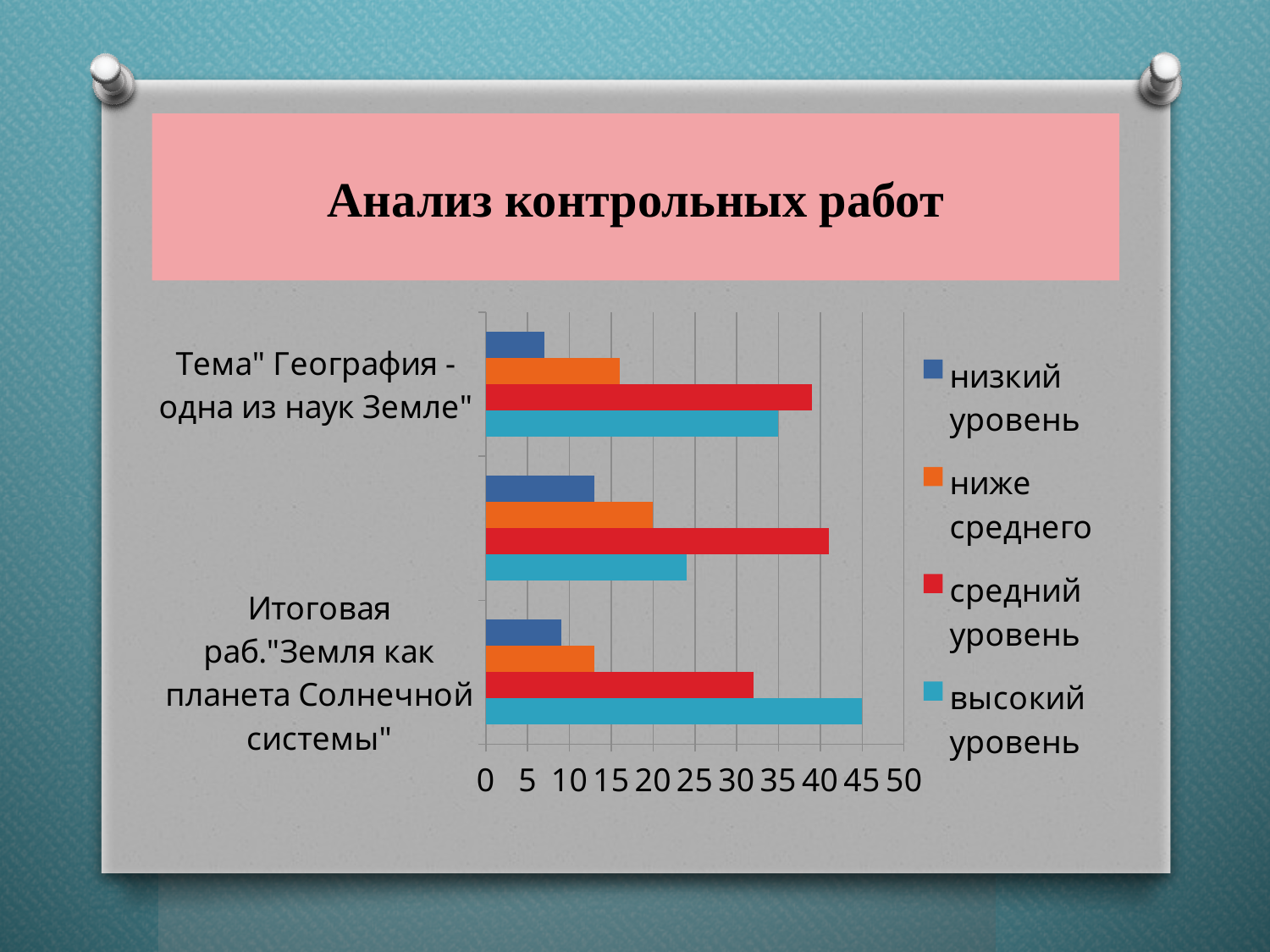
For "Тема" География - одна из наук Земле"", which level has the longest bar? средний уровень What is the title of the slide above the chart? Анализ контрольных работ For "Итоговая раб."Земля как планета Солнечной системы"", which level has the longest bar? высокий уровень Is the value for низкий уровень in "Тема" География - одна из наук Земле"" greater or less than 10? less Which legend entry is shown in red? средний уровень What kind of chart is shown on the slide? bar chart How many series does the legend list? 4 For "Тема" География - одна из наук Земле"", which level has the shortest bar? низкий уровень Is the value for средний уровень in "Тема" География - одна из наук Земле"" greater or less than 35? greater How many groups of bars are plotted on the chart? 3 Is the value for высокий уровень in "Итоговая раб."Земля как планета Солнечной системы"" greater or less than 40? greater In "Итоговая раб."Земля как планета Солнечной системы"", which is larger: высокий уровень or средний уровень? высокий уровень